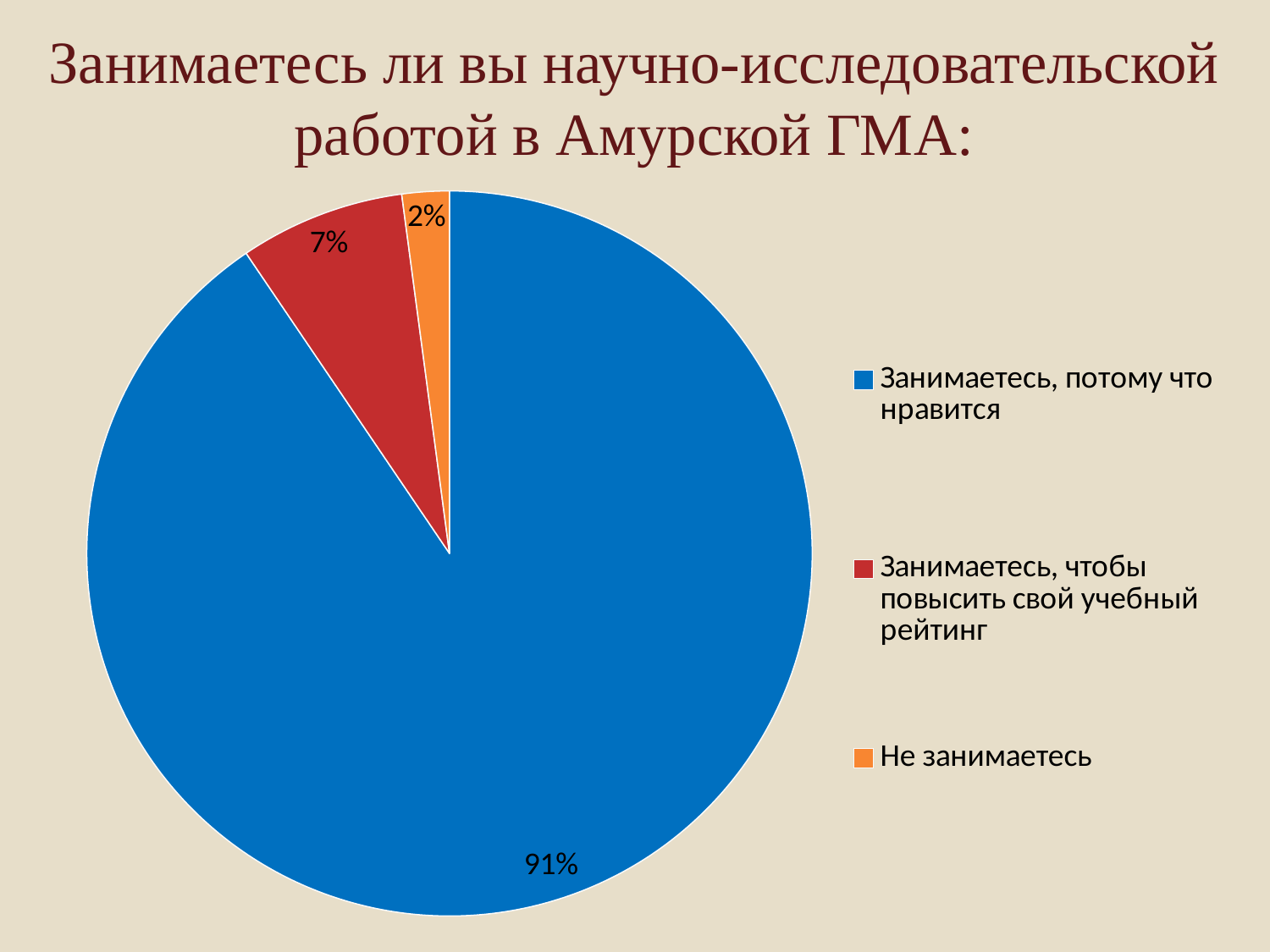
What share of the pie is labelled "Занимаетесь, чтобы повысить свой учебный рейтинг"? 7% What is the difference in percentage points between the "Занимаетесь, чтобы повысить свой учебный рейтинг" slice and the "Не занимаетесь" slice? 5 What colour is the slice for "Не занимаетесь"? Orange What share of the pie is labelled "Не занимаетесь"? 2% What type of chart is shown on the slide? Pie chart How many entries does the legend list? 3 How many slices does the pie chart have? 3 What share of the pie is labelled "Занимаетесь, потому что нравится"? 91% What is the difference in percentage points between the "Занимаетесь, потому что нравится" slice and the "Занимаетесь, чтобы повысить свой учебный рейтинг" slice? 84 Which is larger: the "Занимаетесь, чтобы повысить свой учебный рейтинг" slice or the "Не занимаетесь" slice? Занимаетесь, чтобы повысить свой учебный рейтинг Which category has the smallest slice of the pie? Не занимаетесь Which category has the largest slice of the pie? Занимаетесь, потому что нравится